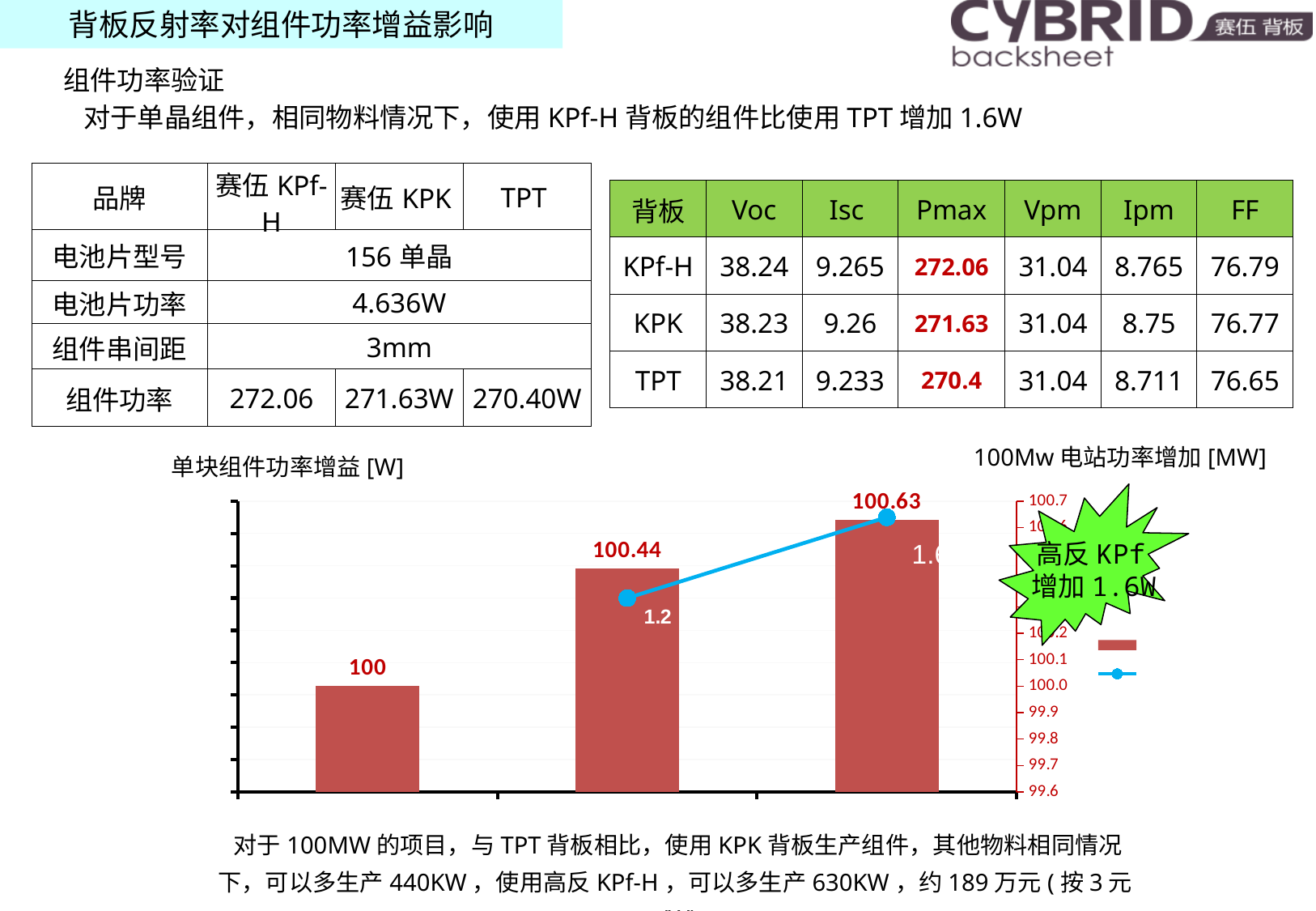
How many bars are plotted in the chart? 3 What is the difference between the middle bar's value and the leftmost bar's value? 0.44 What value is printed above the leftmost bar in the bar chart? 100 What kind of chart is shown on the slide? Bar chart (with a line series overlaid) Which is larger, the middle bar's value or the rightmost bar's value? The rightmost bar's value Which bar in the chart is the tallest? The rightmost bar Do the bar values rise or fall from left to right? Rise Which bar in the chart is the shortest? The leftmost bar What value is printed above the middle bar in the bar chart? 100.44 What value is printed above the rightmost bar in the bar chart? 100.63 What is the difference between the rightmost bar's value and the leftmost bar's value? 0.63 What is the data label on the line point above the middle bar? 1.2